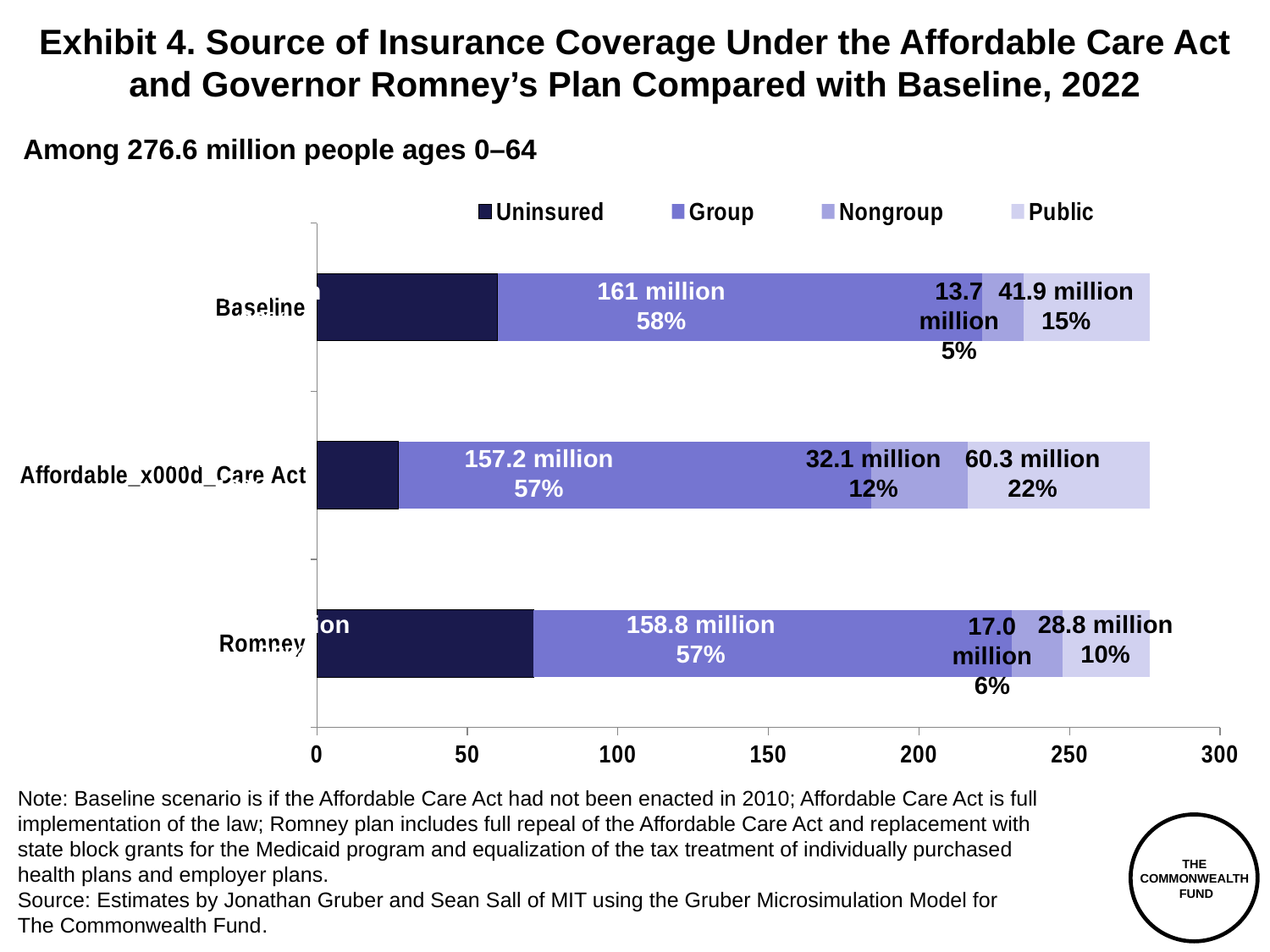
How many scenarios (bars) are shown in the chart? 3 Which scenario has the highest Public coverage value? Affordable Care Act What is the difference between the Nongroup values for the Affordable Care Act and Romney scenarios? 15.1 million Which is larger, the Group value for Romney or the Group value for the Affordable Care Act? Romney Is the Uninsured value for the Romney scenario greater or less than 50? greater How much larger is the Public value under the Affordable Care Act than under the Baseline, in millions? 18.4 million What is the Group value for the Affordable Care Act scenario? 157.2 million What percentage of people are covered by Public insurance under the Romney scenario? 10% Which scenario has the lowest Nongroup coverage value? Baseline What is the Nongroup value for the Baseline scenario? 13.7 million How many series does the legend list? 4 Is the Uninsured value for the Affordable Care Act scenario greater or less than 50? less